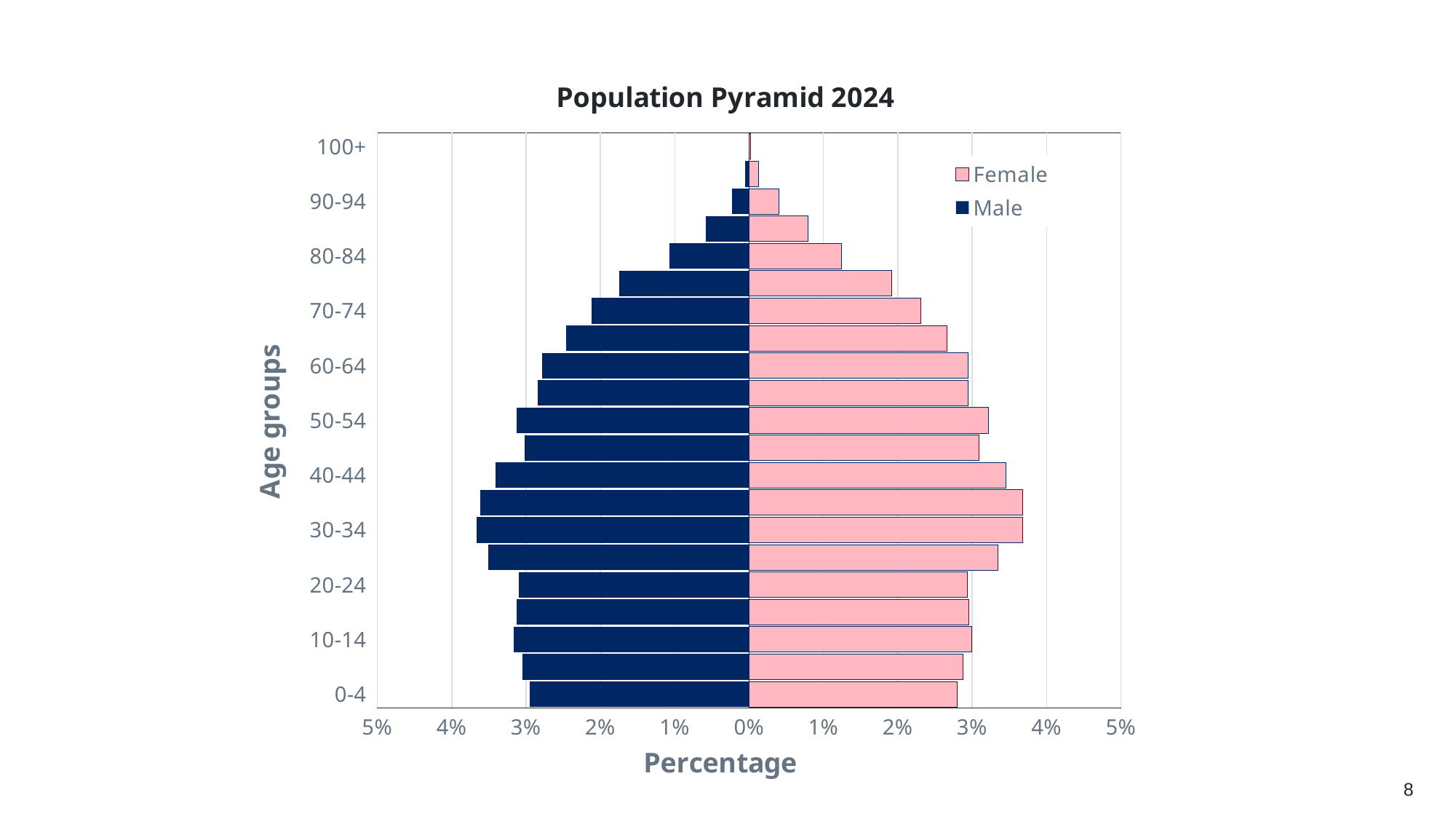
Moving from the 40-44 age group up to 100+, do the Male bars get longer or shorter? shorter Which is larger, the Male value for 30-34 or the Male value for 80-84? 30-34 Is the Male value for the 60-64 age group greater or less than 3%? less For the 90-94 age group, which is larger, the Male value or the Female value? Female Is the Female value for the 70-74 age group greater or less than 2%? greater Is the Male value for the 30-34 age group greater or less than 3%? greater Which series is shown in dark blue? Male What kind of chart is shown on the slide? bar chart What is the title of the chart? Population Pyramid 2024 Which labeled age group has the smallest Male value? 100+ How many series does the legend list? 2